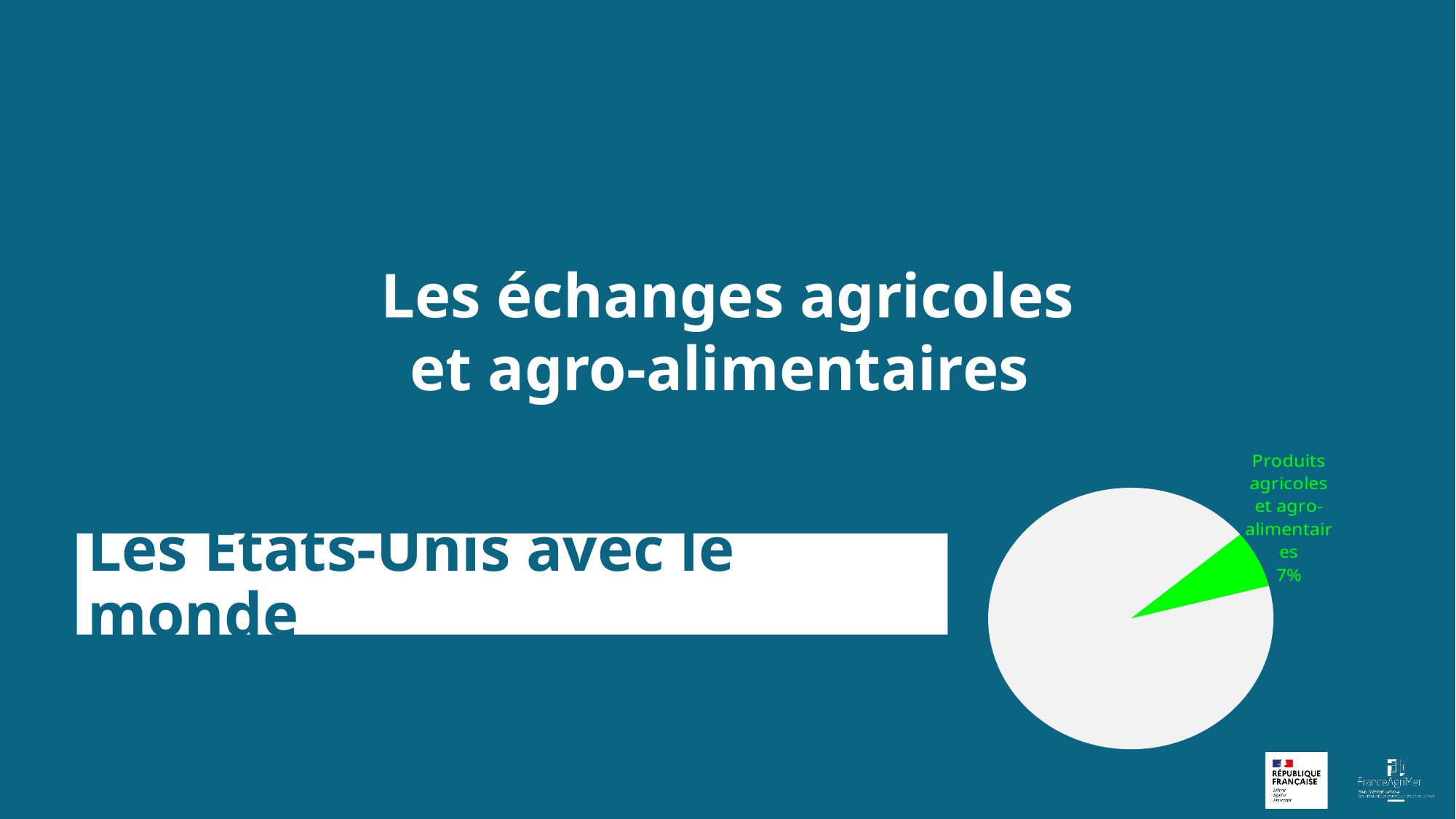
How many slices does the pie chart have? 2 Which is larger: the green slice for "Produits agricoles et agro-alimentaires" or the grey slice? the grey slice What kind of chart is shown on the slide? pie chart What share of the pie does the slice labelled "Produits agricoles et agro-alimentaires" represent? 7% Which slice of the pie chart has a data label? Produits agricoles et agro-alimentaires Is the share for "Produits agricoles et agro-alimentaires" greater or less than 10%? less What colour is the slice labelled "Produits agricoles et agro-alimentaires"? green Which slice of the pie chart is the smallest? Produits agricoles et agro-alimentaires